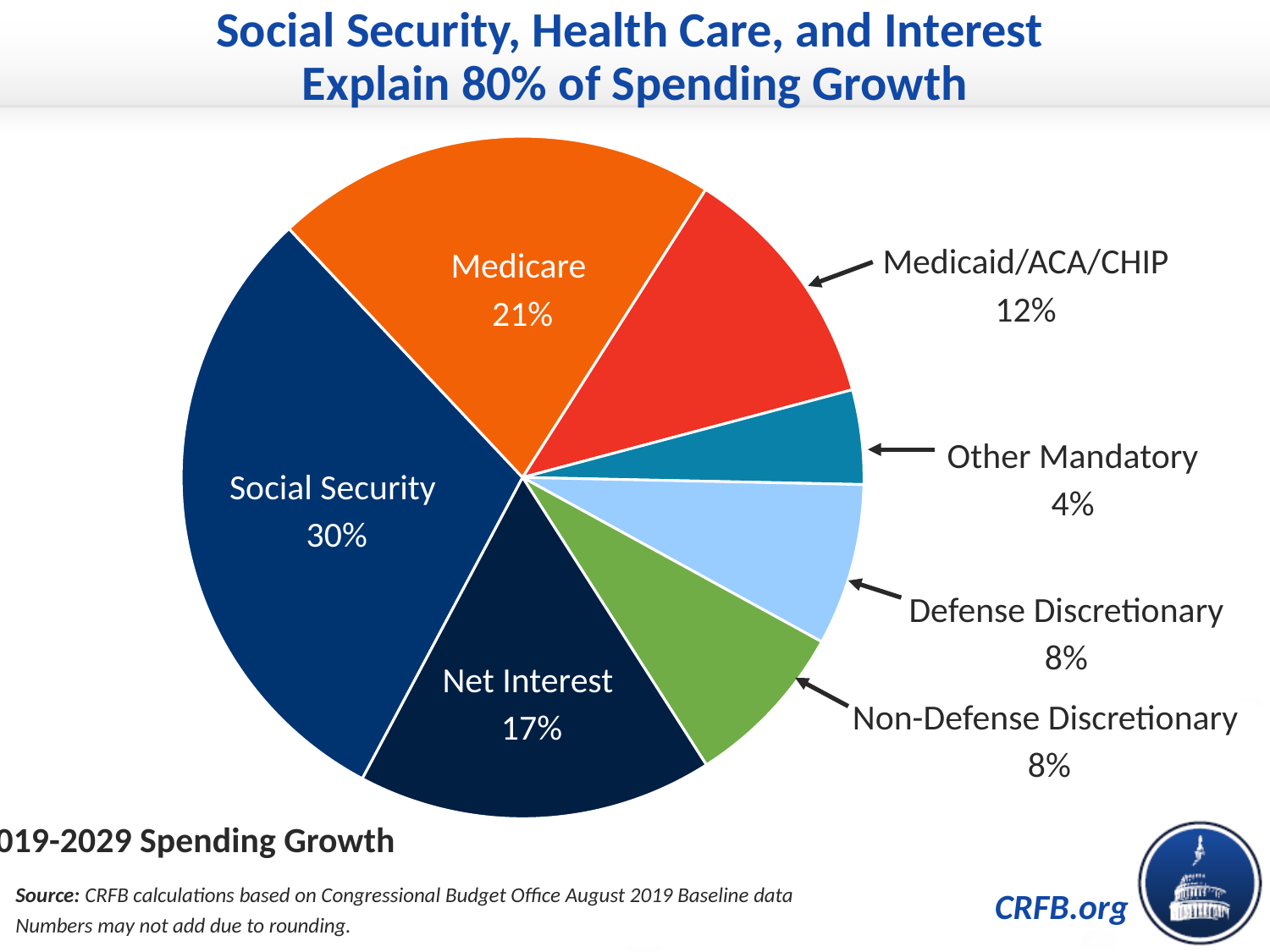
What share of spending growth does Net Interest account for? 17% Which category has the largest slice of the pie? Social Security Which is larger, the share for Net Interest or the share for Medicaid/ACA/CHIP? Net Interest What is the difference in percentage points between Social Security and Medicare? 9 What is the title of the chart? Social Security, Health Care, and Interest Explain 80% of Spending Growth How many categories are shown in the pie chart? 7 What share of spending growth does Medicaid/ACA/CHIP account for? 12% What share of spending growth does Social Security account for? 30% What kind of chart is shown on the slide? pie chart What share of spending growth does Medicare account for? 21% What share of spending growth does Other Mandatory account for? 4% Which category has the smallest slice of the pie? Other Mandatory